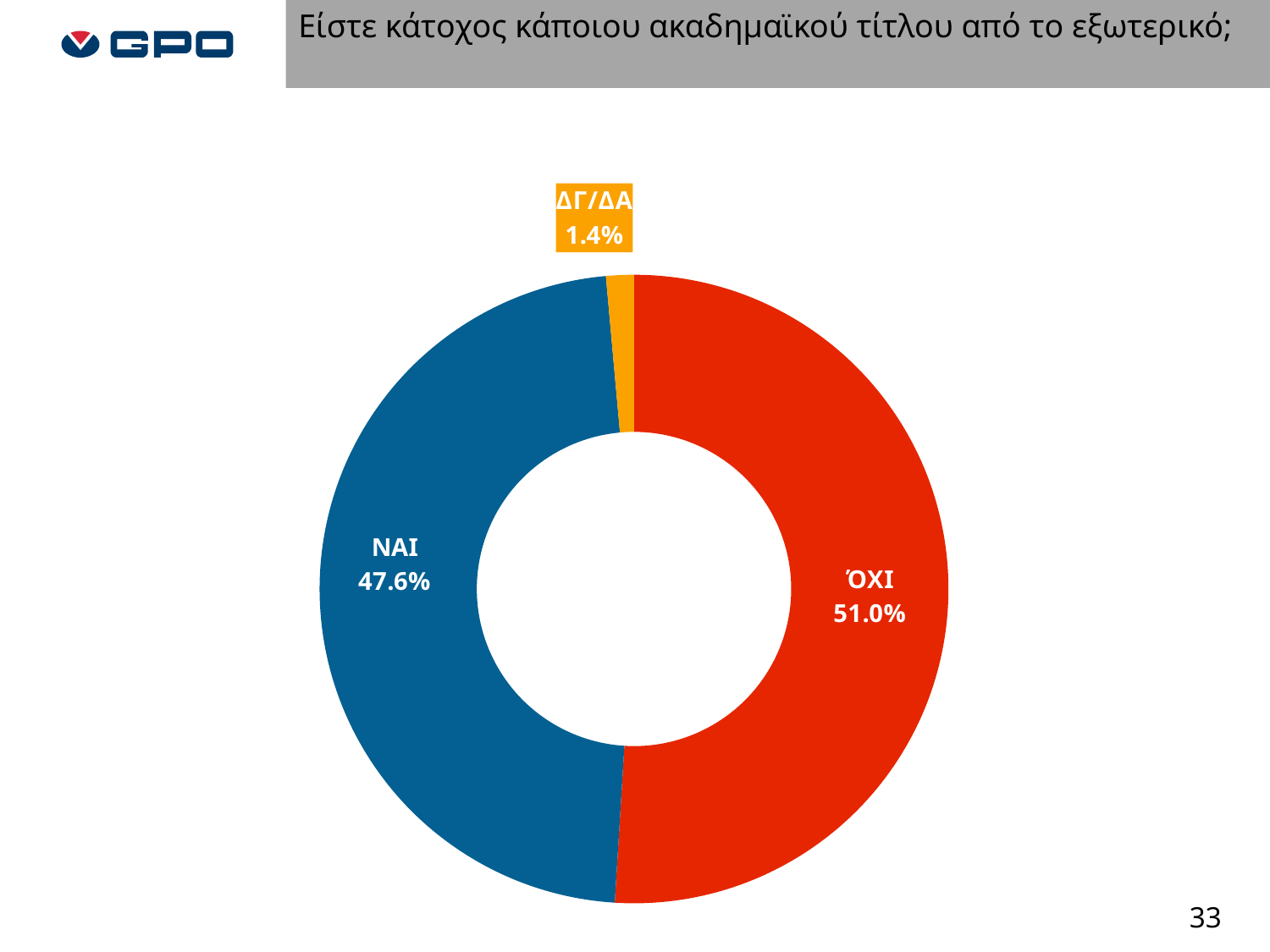
What percentage of respondents answered ΝΑΙ? 47.6% What is the combined share of ΝΑΙ and ΌΧΙ? 98.6% What percentage of respondents answered ΌΧΙ? 51.0% Which category has the smallest share of the chart? ΔΓ/ΔΑ What is the value shown for ΔΓ/ΔΑ? 1.4% How many categories are shown in the chart? 3 Which is larger, the share for ΝΑΙ or the share for ΌΧΙ? ΌΧΙ What kind of chart is shown on the slide? Doughnut (pie) chart What question is shown as the title of the slide? Είστε κάτοχος κάποιου ακαδημαϊκού τίτλου από το εξωτερικό; Which category has the largest share of the chart? ΌΧΙ What is the difference in percentage points between ΌΧΙ and ΝΑΙ? 3.4 What colour is the ΝΑΙ segment of the chart? Blue